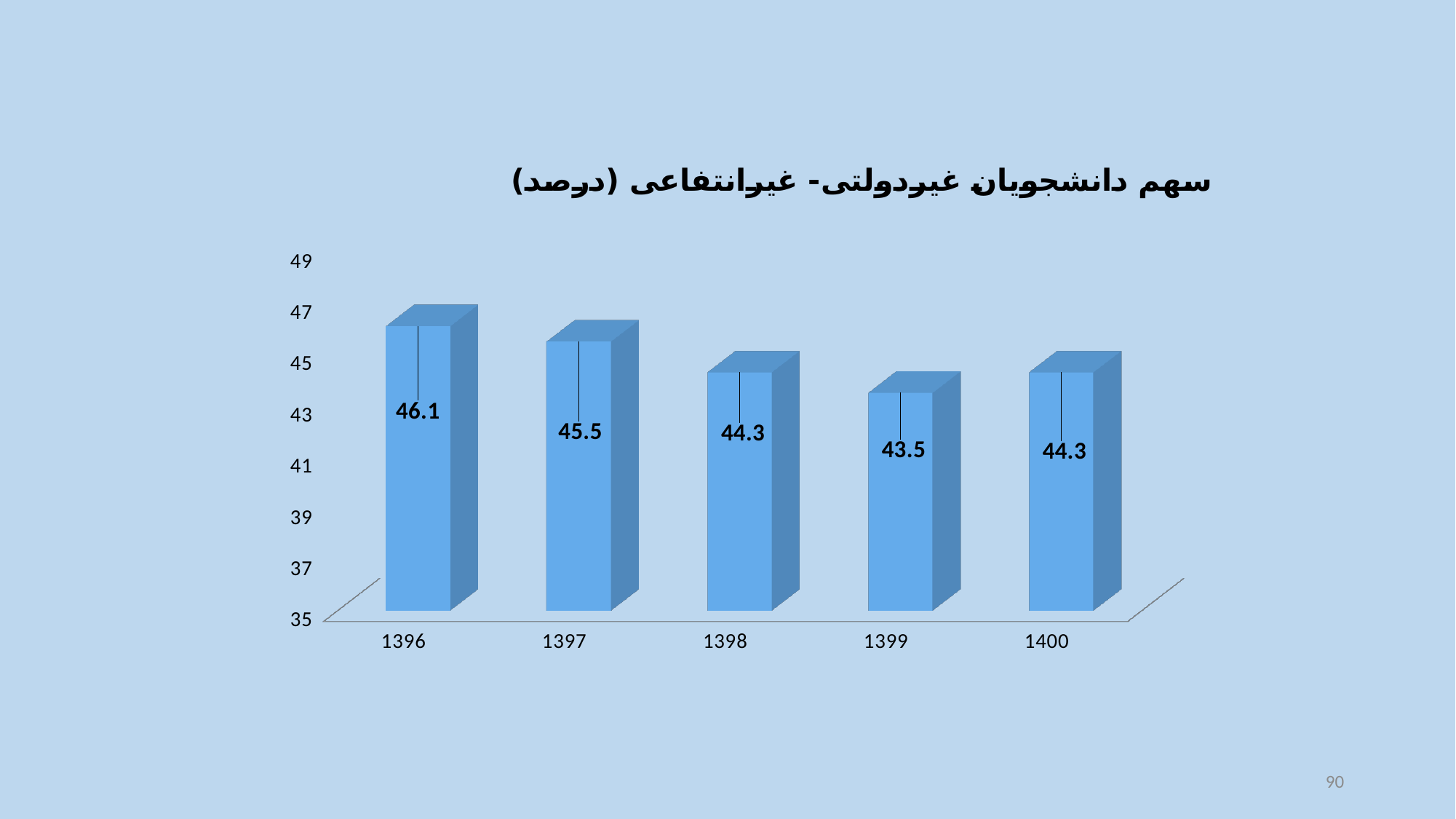
What is the difference between the values for 1397 and 1398? 1.2 What kind of chart is shown on the slide? bar chart What is the difference between the values for 1396 and 1399? 2.6 Do the values rise or fall from 1396 to 1399? fall How many years are shown on the x axis? 5 Is the value for 1396 greater or less than 45? greater Which year has the lowest value? 1399 Which year has the highest value? 1396 What is the value for 1400? 44.3 Which is larger, the value for 1397 or the value for 1400? 1397 What is the value for 1399? 43.5 What is the value for 1396? 46.1